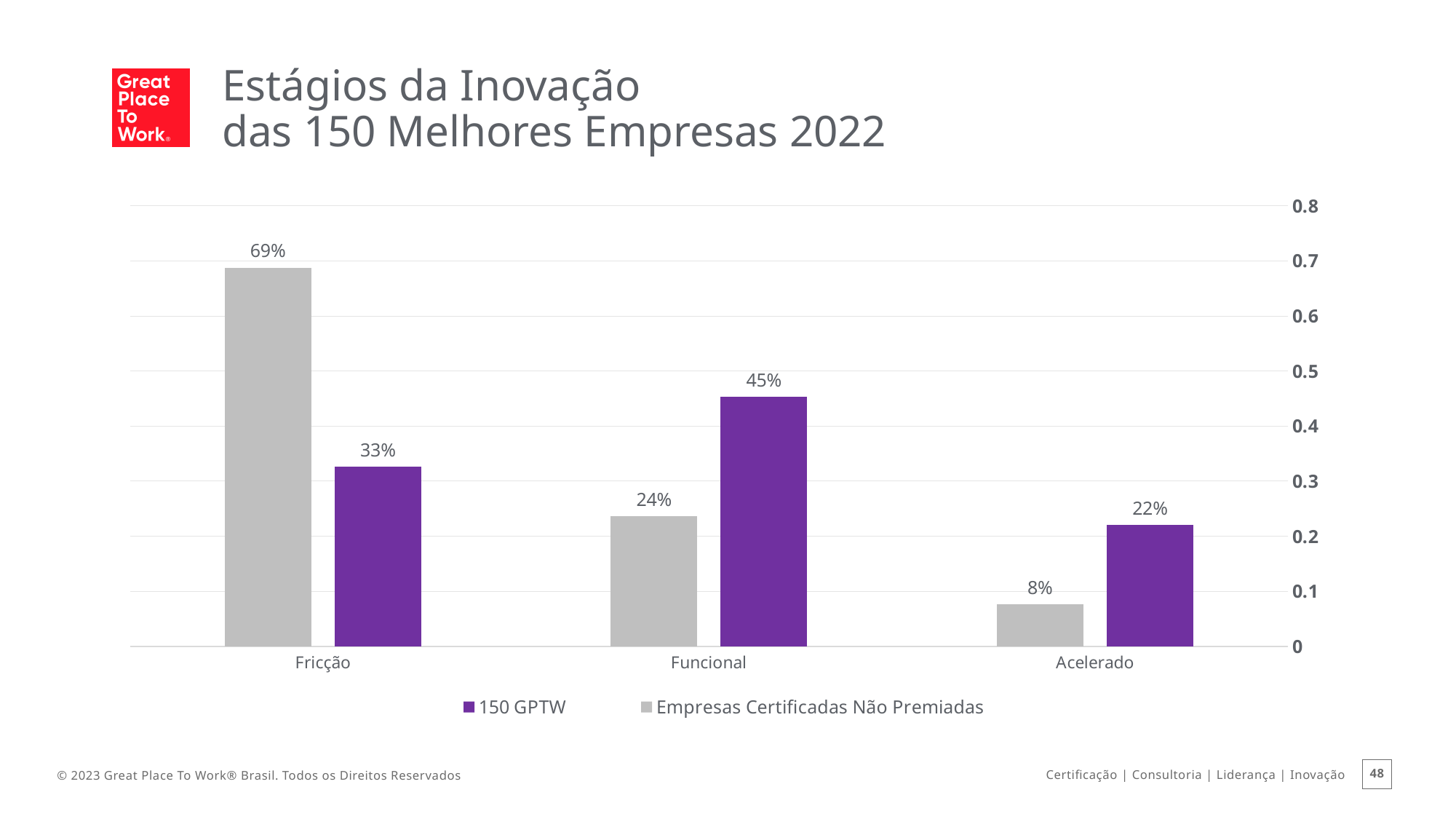
In the Funcional category, which series has the larger value: 150 GPTW or Empresas Certificadas Não Premiadas? 150 GPTW What is the value for 150 GPTW in the Funcional category? 45% Which category has the lowest value for Empresas Certificadas Não Premiadas? Acelerado What is the value for Empresas Certificadas Não Premiadas in the Fricção category? 69% What is the value for Empresas Certificadas Não Premiadas in the Acelerado category? 8% What colour are the bars for the 150 GPTW series? Purple What kind of chart is shown on the slide? Bar chart What is the value for 150 GPTW in the Fricção category? 33% How many series does the legend list? 2 How many categories are shown on the x axis? 3 What is the difference between the Empresas Certificadas Não Premiadas value and the 150 GPTW value in the Fricção category? 36% Which category has the highest value for 150 GPTW? Funcional